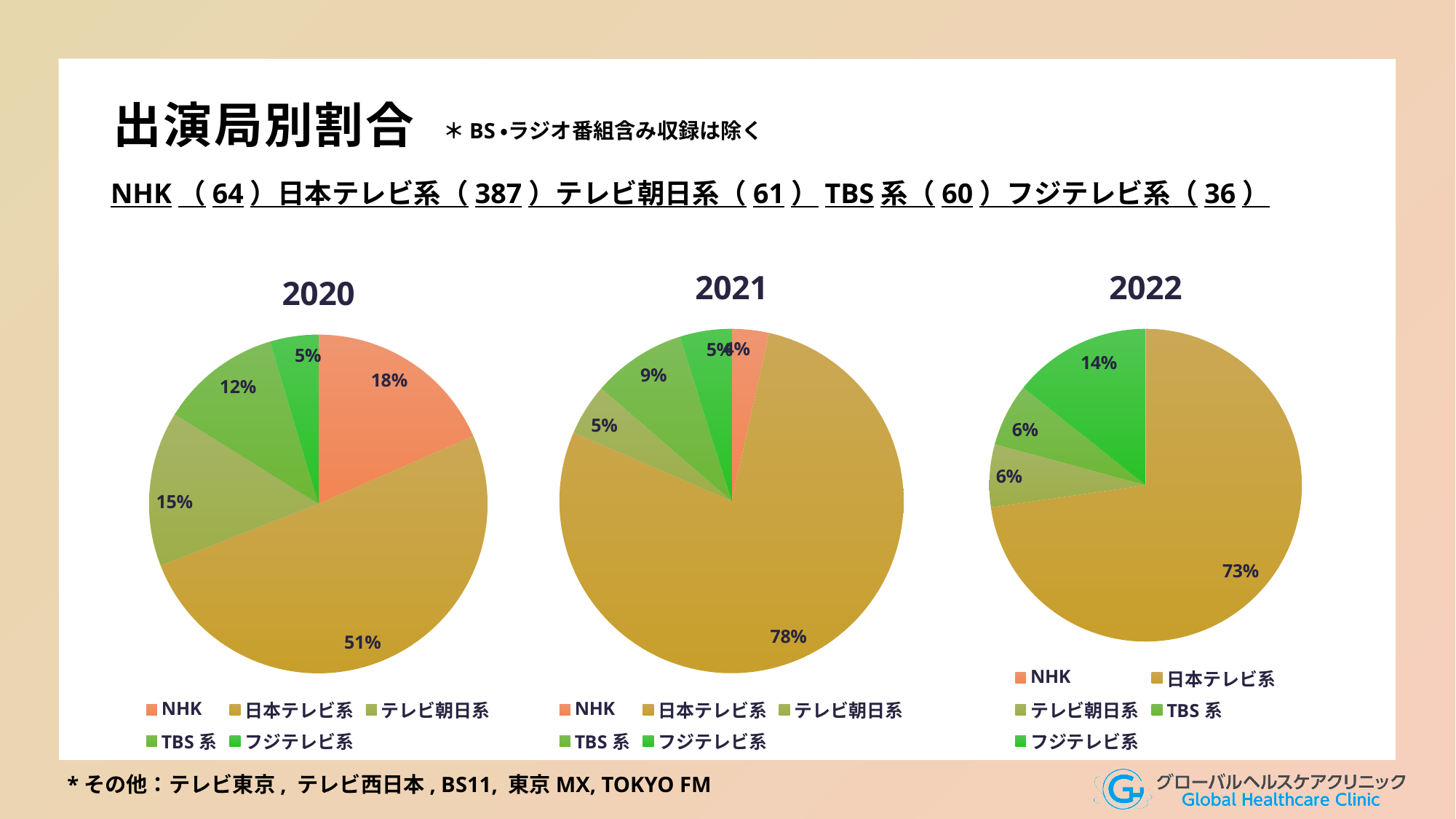
In the 2020 pie chart, which station has the largest share? 日本テレビ系 In the 2022 pie chart, what share does フジテレビ系 have? 14% In the 2021 pie chart, what share does 日本テレビ系 have? 78% In the 2020 pie chart, which is larger, the share of テレビ朝日系 or the share of TBS系? テレビ朝日系 In the 2022 pie chart, what share does 日本テレビ系 have? 73% How many entries does the legend of the 2021 pie chart list? 5 What kind of chart is used for the 2022 data? Pie chart How many pie charts are shown on the slide? 3 In the 2020 pie chart, what share does NHK have? 18% In the 2021 pie chart, what is the difference between the shares of 日本テレビ系 and TBS系? 69% In the 2020 pie chart, which station has the smallest share? フジテレビ系 In the 2020 pie chart, what share does 日本テレビ系 have? 51%